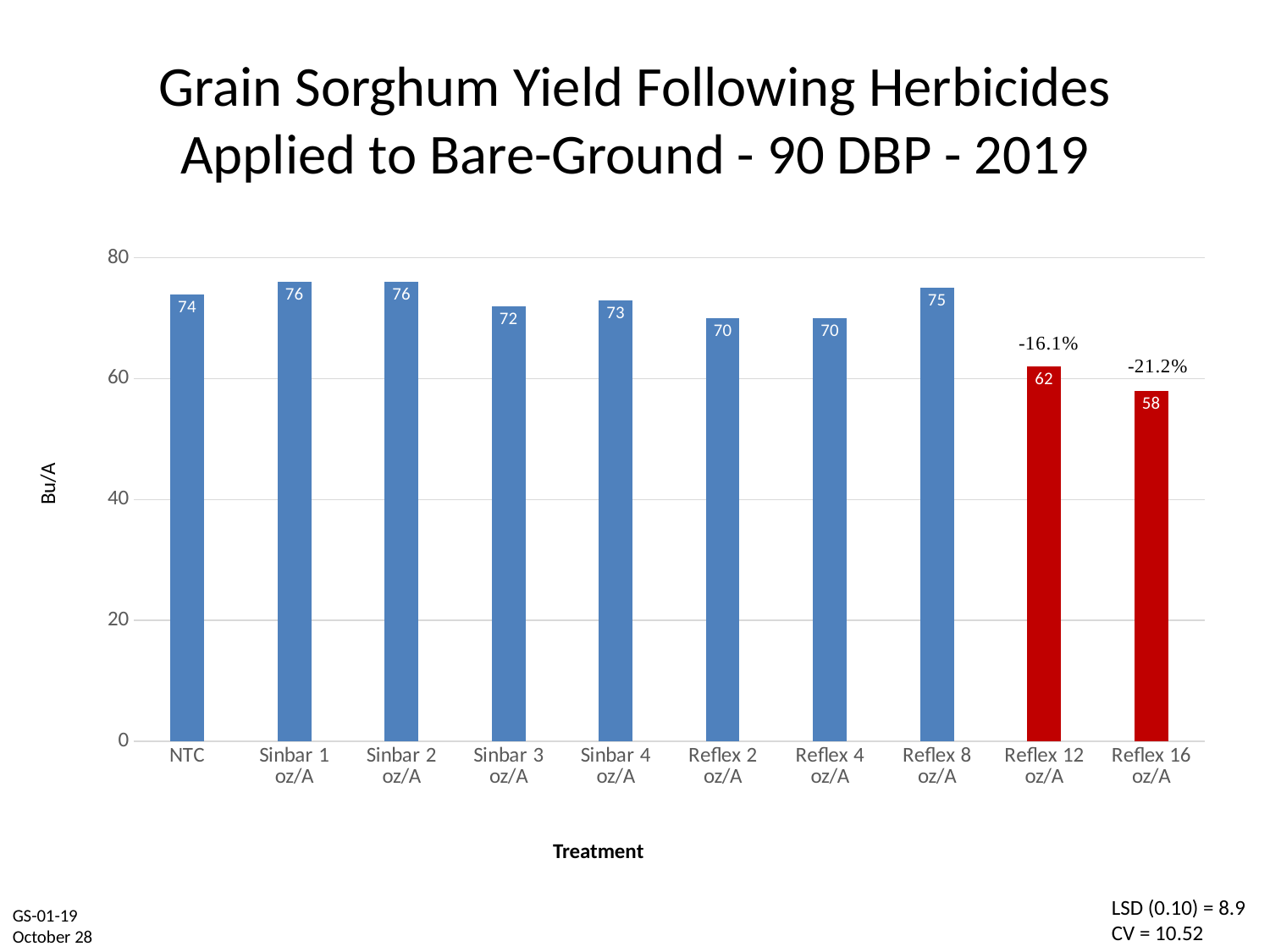
What kind of chart is shown on the slide? Bar chart What percentage change is labelled above the Reflex 12 oz/A bar? -16.1% What is the yield for Sinbar 3 oz/A? 72 Is the value for Reflex 16 oz/A greater or less than 60? less What is the yield for Reflex 16 oz/A? 58 What is the difference in yield between NTC and Reflex 12 oz/A? 12 How many treatments are shown on the x axis? 10 What is the yield for the NTC treatment? 74 What is the difference in yield between Sinbar 1 oz/A and Reflex 16 oz/A? 18 Which treatment has the lowest yield? Reflex 16 oz/A What is the label of the y axis? Bu/A Which has a higher yield, Reflex 8 oz/A or Reflex 2 oz/A? Reflex 8 oz/A